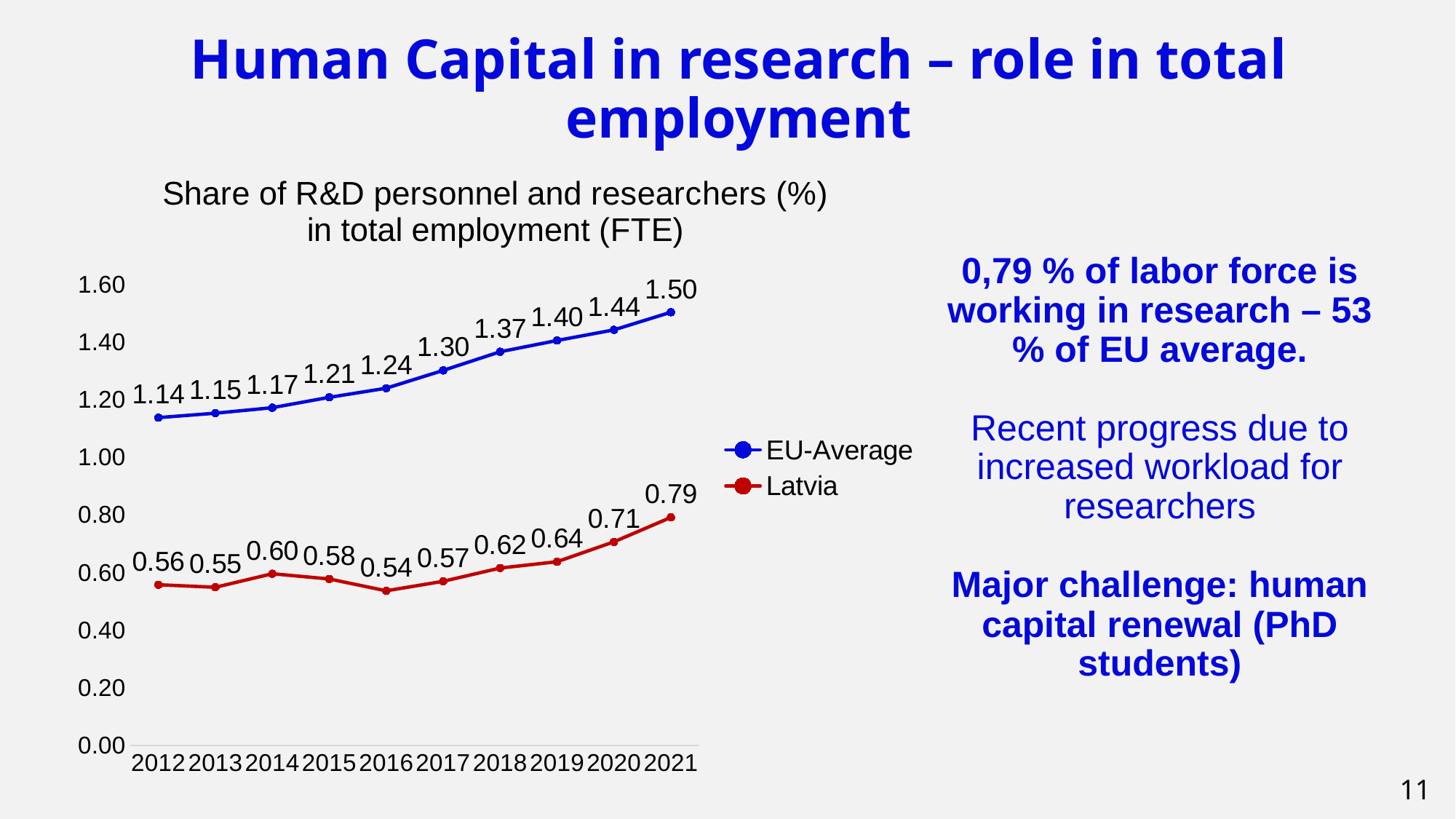
What kind of chart is shown on the slide? Line chart Which series has the higher value in 2018, EU-Average or Latvia? EU-Average What is the EU-Average value in 2021? 1.50 In which year is the Latvia series at its lowest? 2016 What is the title of the chart? Share of R&D personnel and researchers (%) in total employment (FTE) What is the value for Latvia in 2012? 0.56 What is the difference between the EU-Average and Latvia values in 2021? 0.71 How many years are shown on the x axis? 10 How many series does the legend list? 2 Does the EU-Average series rise or fall from 2012 to 2021? Rise What is the value for Latvia in 2016? 0.54 In which year is the EU-Average series at its highest? 2021